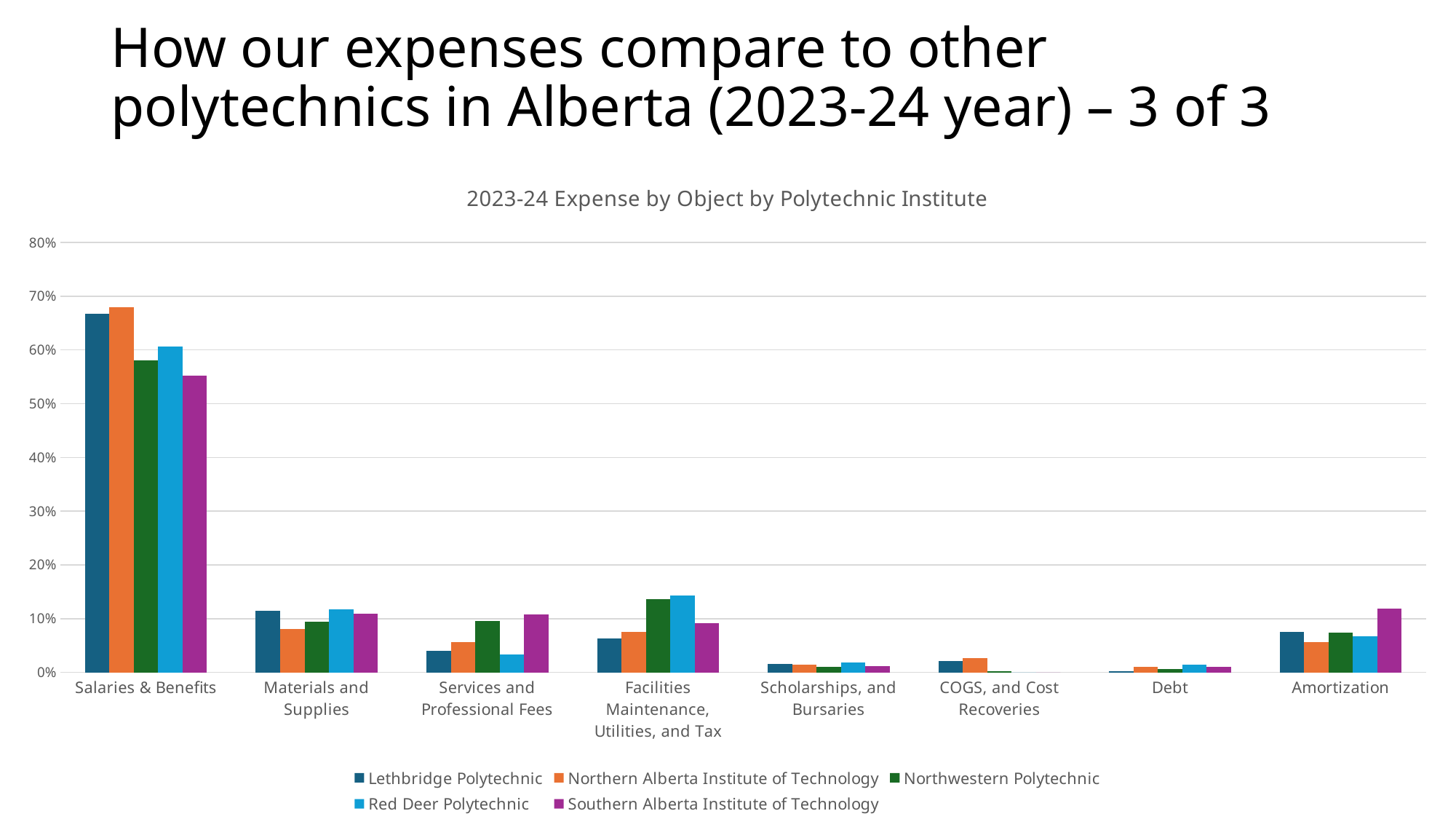
How many series does the legend list? 5 What is the title of the chart? 2023-24 Expense by Object by Polytechnic Institute What kind of chart is shown on the slide? Bar chart Which institution has the highest value for Salaries & Benefits? Northern Alberta Institute of Technology Is the value for Southern Alberta Institute of Technology in Salaries & Benefits greater or less than 60%? less Which institution has the lowest value for Salaries & Benefits? Southern Alberta Institute of Technology In Services and Professional Fees, which is larger: Southern Alberta Institute of Technology or Red Deer Polytechnic? Southern Alberta Institute of Technology How many expense categories are shown along the x axis? 8 In Facilities Maintenance, Utilities, and Tax, which is larger: Northwestern Polytechnic or Lethbridge Polytechnic? Northwestern Polytechnic Is the value for Red Deer Polytechnic in Facilities Maintenance, Utilities, and Tax greater or less than 10%? greater Which institution has the highest value for Amortization? Southern Alberta Institute of Technology Is the value for Lethbridge Polytechnic in Salaries & Benefits greater or less than 60%? greater